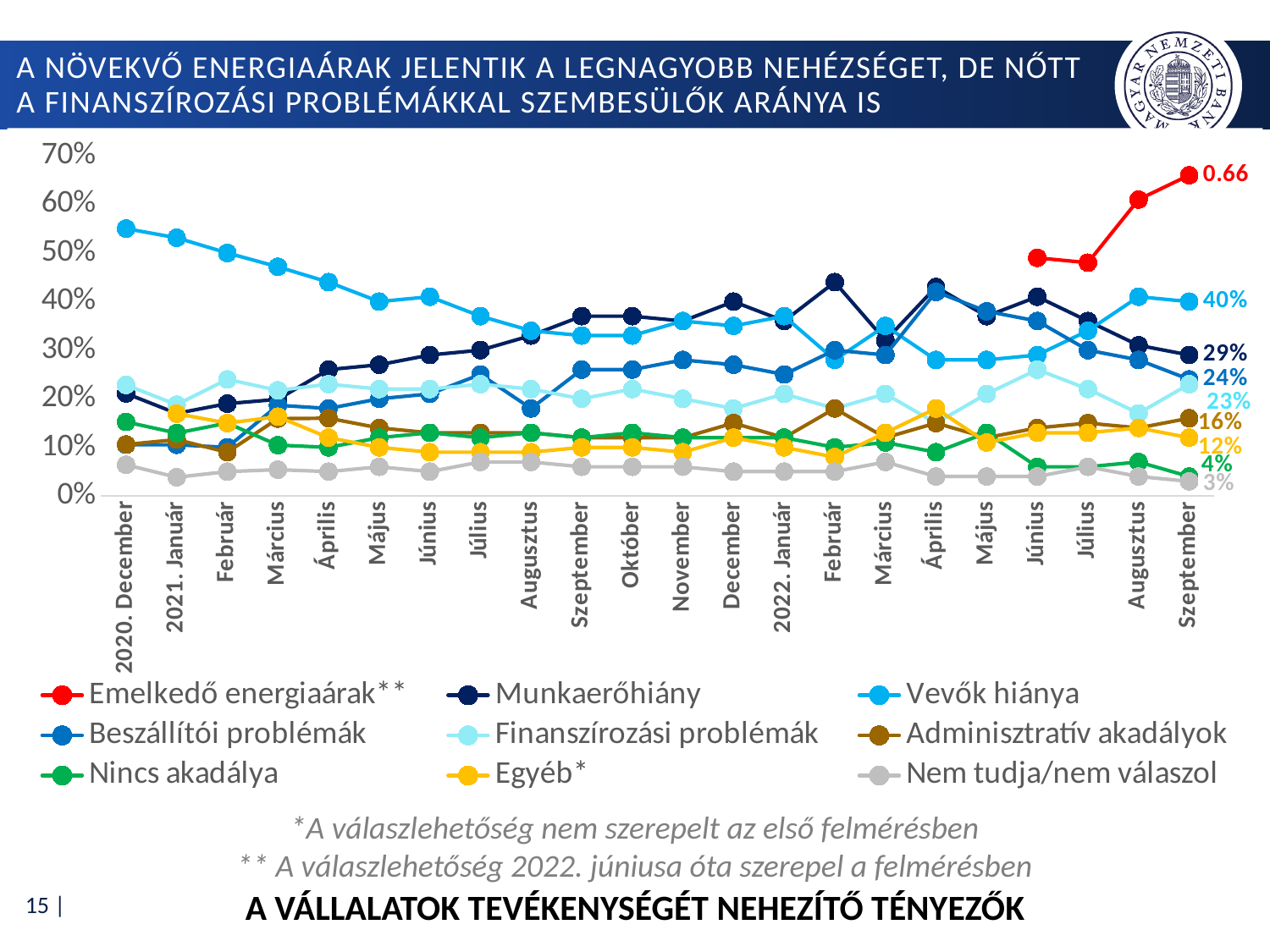
What is the value for Emelkedő energiaárak** at the last point (Szeptember 2022)? 0.66 How many series does the legend list? 9 What is the value for Vevők hiánya at the last point (Szeptember 2022)? 40% Is the value for Vevők hiánya at 2020. December greater or less than 50%? greater At the last point (Szeptember 2022), which is larger: Adminisztratív akadályok or Egyéb*? Adminisztratív akadályok What is the difference between Vevők hiánya (40%) and Munkaerőhiány (29%) at the last point (Szeptember 2022)? 11 percentage points What is the value for Finanszírozási problémák at the last point (Szeptember 2022)? 23% What kind of chart is shown on the slide? Line chart What is the value for Nem tudja/nem válaszol at the last point (Szeptember 2022)? 3% What is the value for Munkaerőhiány at the last point (Szeptember 2022)? 29% Which series has the lowest value at the last point (Szeptember 2022)? Nem tudja/nem válaszol Which series has the highest value at the last point (Szeptember 2022)? Emelkedő energiaárak**